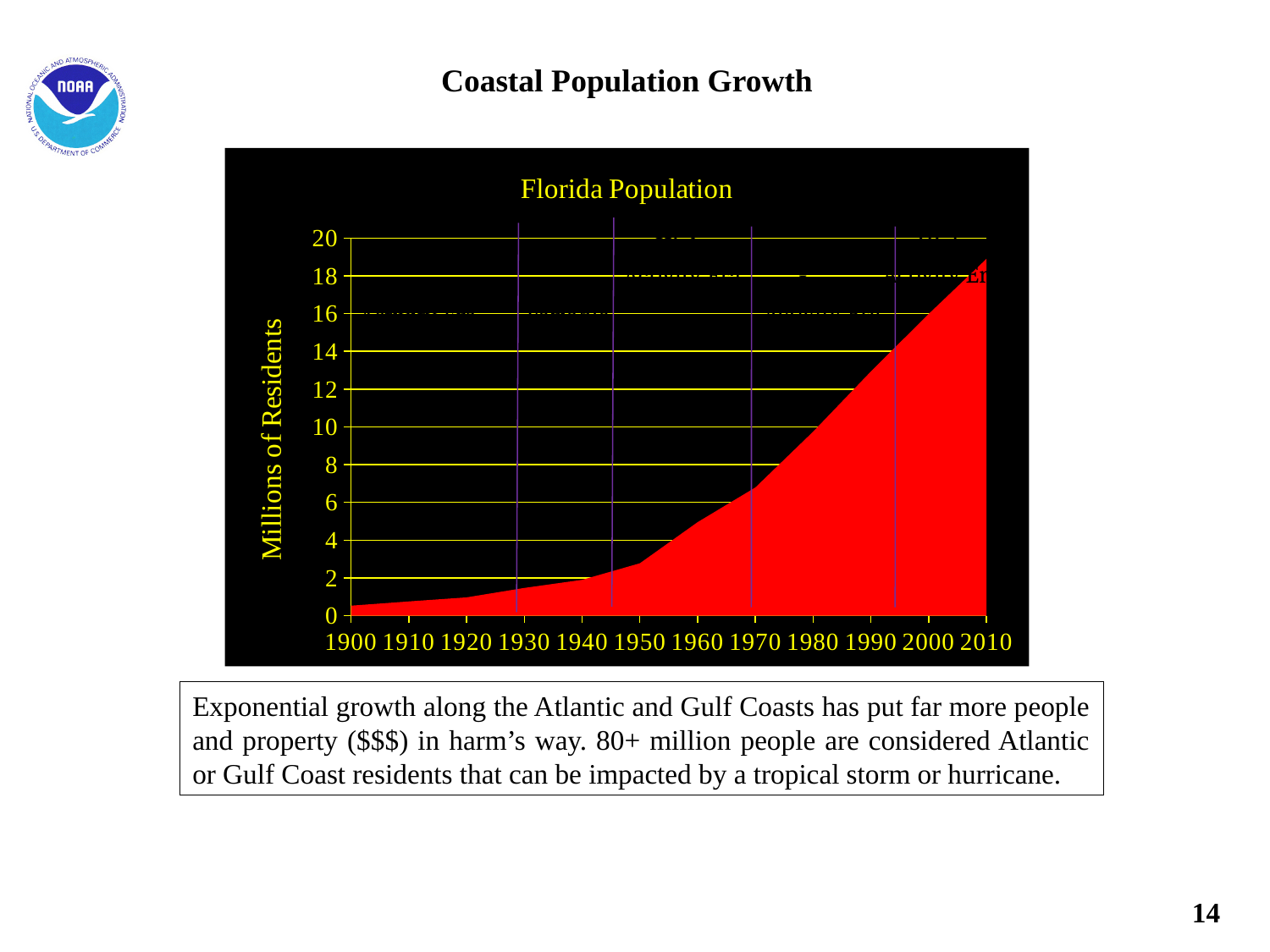
What is the title of the chart? Florida Population In which year is the Florida population lowest? 1900 Is the value for 2010 greater or less than 16? greater Which year has the larger Florida population, 1950 or 2000? 2000 What kind of chart is shown on the slide? Area chart Is the value for 1900 greater or less than 2? less How many years are labelled along the x axis of the chart? 12 Is the value for 1950 greater or less than 4? less In which year is the Florida population highest? 2010 What is the label on the vertical axis of the chart? Millions of Residents Does the Florida population rise or fall from 1900 to 2010? Rise